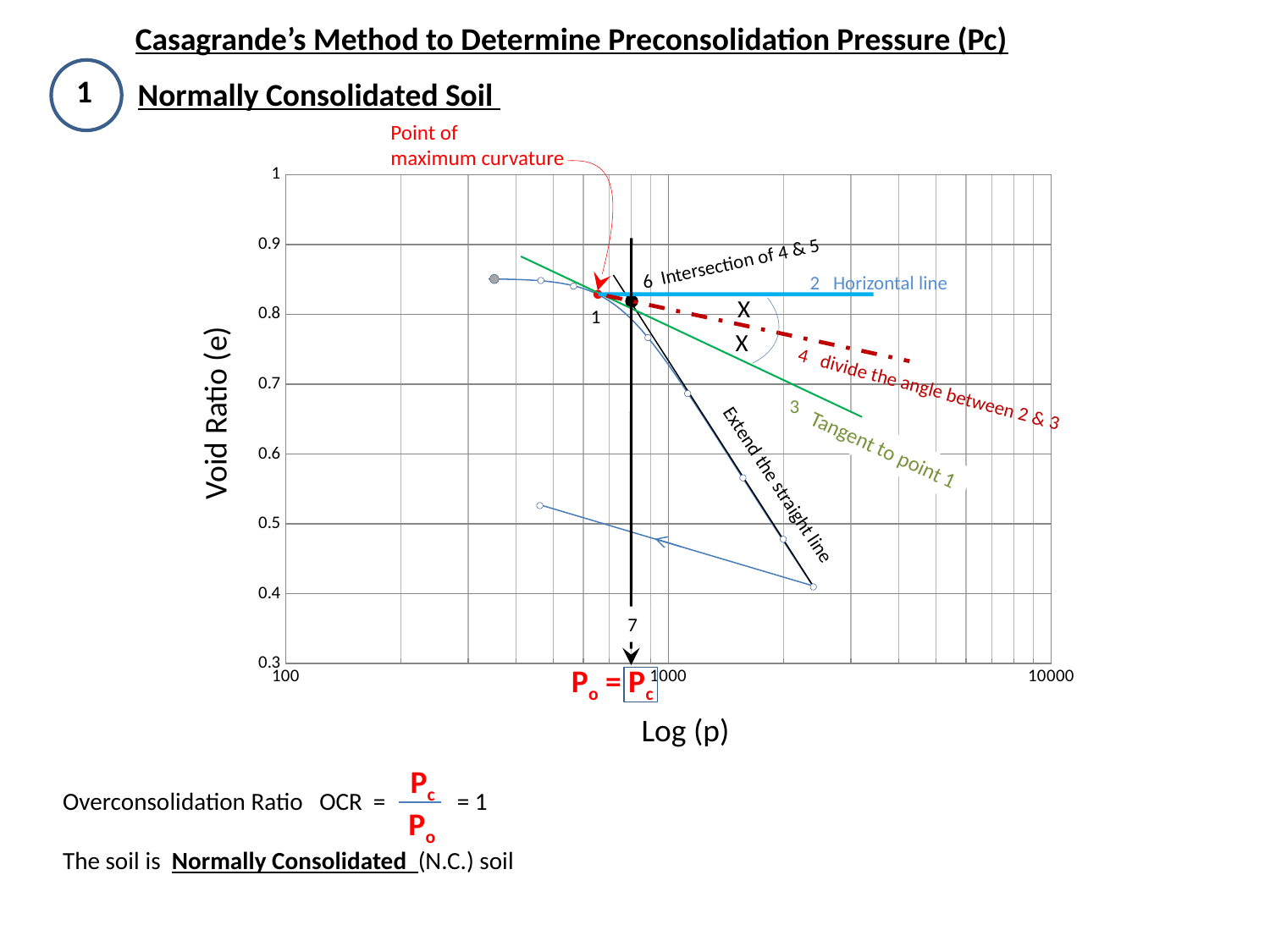
What is the highest value shown on the vertical axis? 1 What is the largest value labelled on the horizontal axis? 10000 What kind of chart is shown on the slide? line chart What is the label of the horizontal axis of the chart? Log (p) Is the void ratio of the lowest data point on the curve greater or less than 0.5? less What is the label of the vertical axis of the chart? Void Ratio (e) Is the void ratio of the leftmost data point greater or less than 0.8? greater Along the loading curve, does the void ratio rise or fall as p increases? fall How many labelled tick values are shown on the horizontal axis? 3 What is the lowest value shown on the vertical axis? 0.3 Is the void ratio at the point of maximum curvature greater or less than 0.7? greater